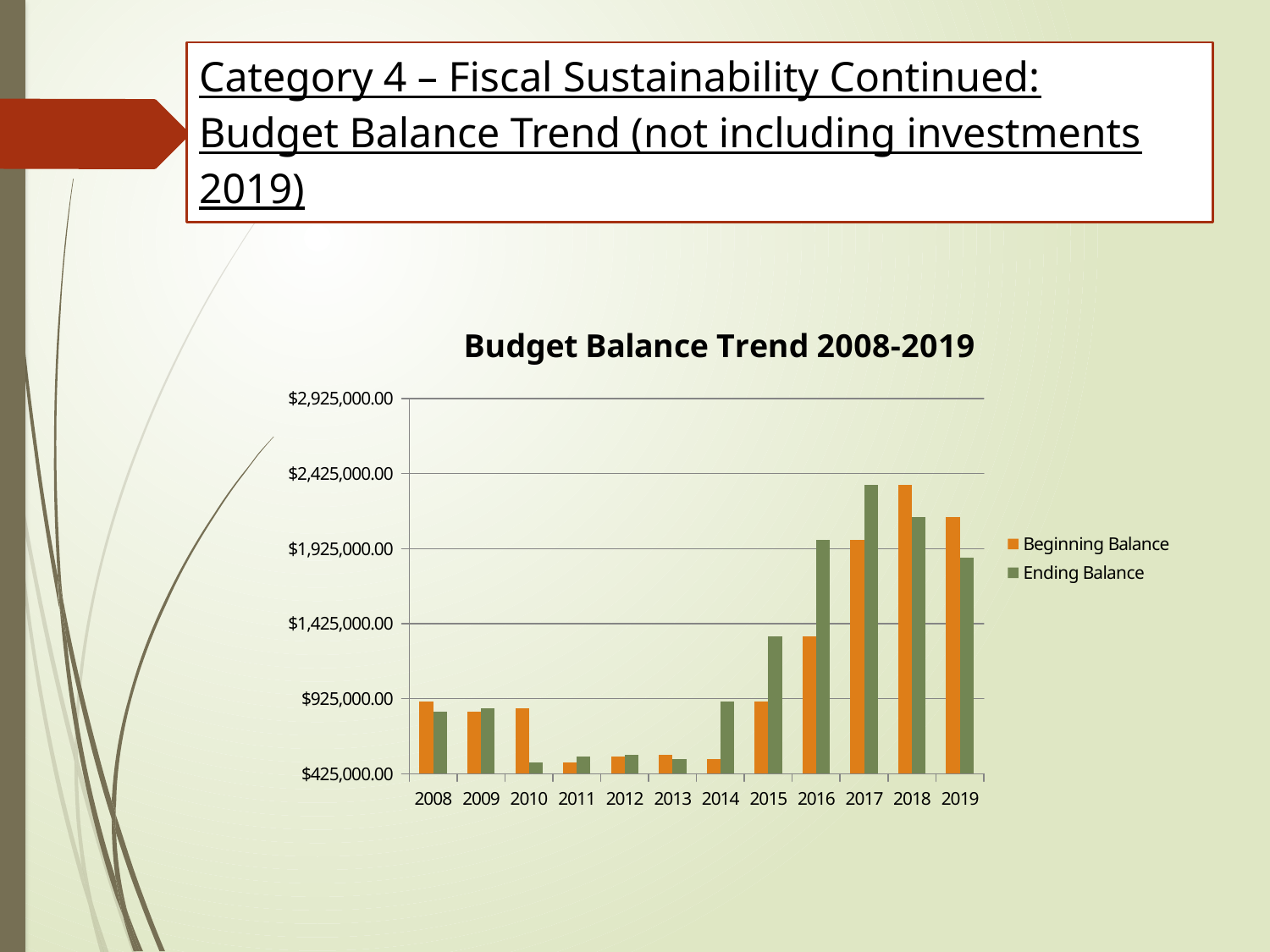
Is the Beginning Balance for 2011 greater or less than $925,000.00? less Does the Beginning Balance rise or fall from 2014 to 2018? Rise Which year has the highest Ending Balance? 2017 Which year has the highest Beginning Balance? 2018 Is the Ending Balance for 2017 greater or less than $1,925,000.00? greater Which year has the lowest Beginning Balance? 2011 How many series does the legend list? 2 In 2019, which is larger, the Beginning Balance or the Ending Balance? Beginning Balance How many years are shown on the x axis of the chart? 12 Is the Ending Balance for 2015 greater or less than $1,425,000.00? less What is the title of the chart? Budget Balance Trend 2008-2019 What kind of chart is shown on the slide? Bar chart